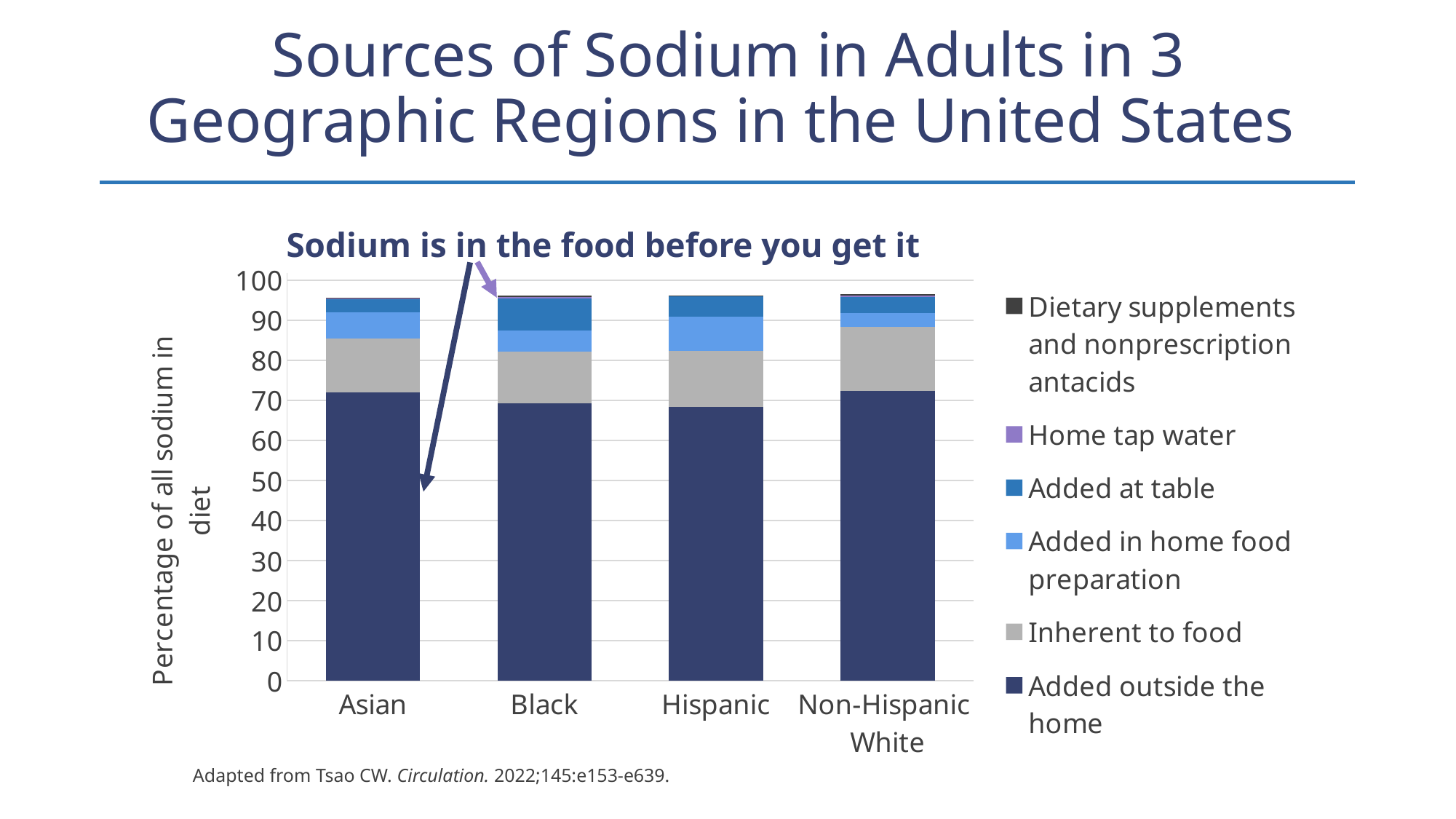
Which group has the largest 'Added in home food preparation' segment? Hispanic Which legend entry is shown in the darkest navy colour at the bottom of each bar? Added outside the home Which group has the smallest 'Added in home food preparation' segment? Non-Hispanic White How many groups (categories) are shown on the x axis of the chart? 4 Which is larger, the 'Added outside the home' value for Asian adults or for Hispanic adults? Asian Which group has the largest 'Added at table' segment? Black What is the label on the chart's vertical axis? Percentage of all sodium in diet Is the 'Added outside the home' value for Hispanic adults greater or less than 70? less What kind of chart is shown on the slide? Stacked bar chart Is the 'Added outside the home' value for Asian adults greater or less than 60? greater How many series does the chart's legend list? 6 Is the total height of the stacked bar for Black adults greater or less than 90? greater